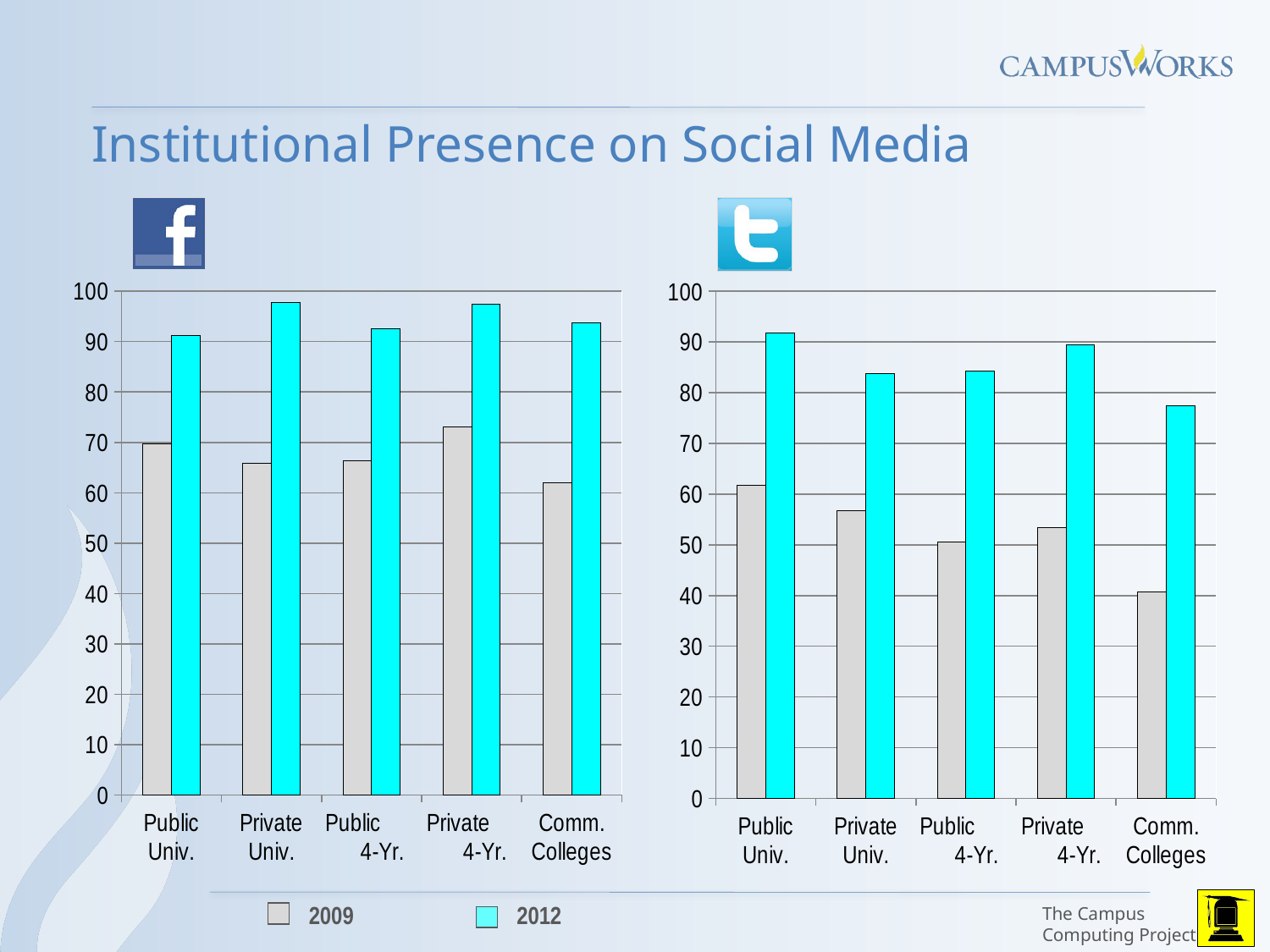
In the Twitter chart on the right, is the 2012 value for Comm. Colleges greater or less than 80? less What kind of chart is the Facebook chart on the left? bar chart In the Facebook chart on the left, is the 2012 value for Comm. Colleges greater or less than 90? greater In the Twitter chart on the right, which is larger for 2009: Private Univ. or Public 4-Yr.? Private Univ. In the Twitter chart on the right, which category has the lowest 2009 value? Comm. Colleges How many series does the legend list for the charts? 2 In the Twitter chart on the right, which category has the lowest 2012 value? Comm. Colleges In the Facebook chart on the left, which category has the lowest 2009 value? Comm. Colleges In the Facebook chart on the left, which category has the highest 2009 value? Private 4-Yr. How many categories are shown on the x axis of the Twitter chart on the right? 5 Which colour represents the 2012 series in the charts? cyan In the Twitter chart on the right, is the 2009 value for Comm. Colleges greater or less than 50? less